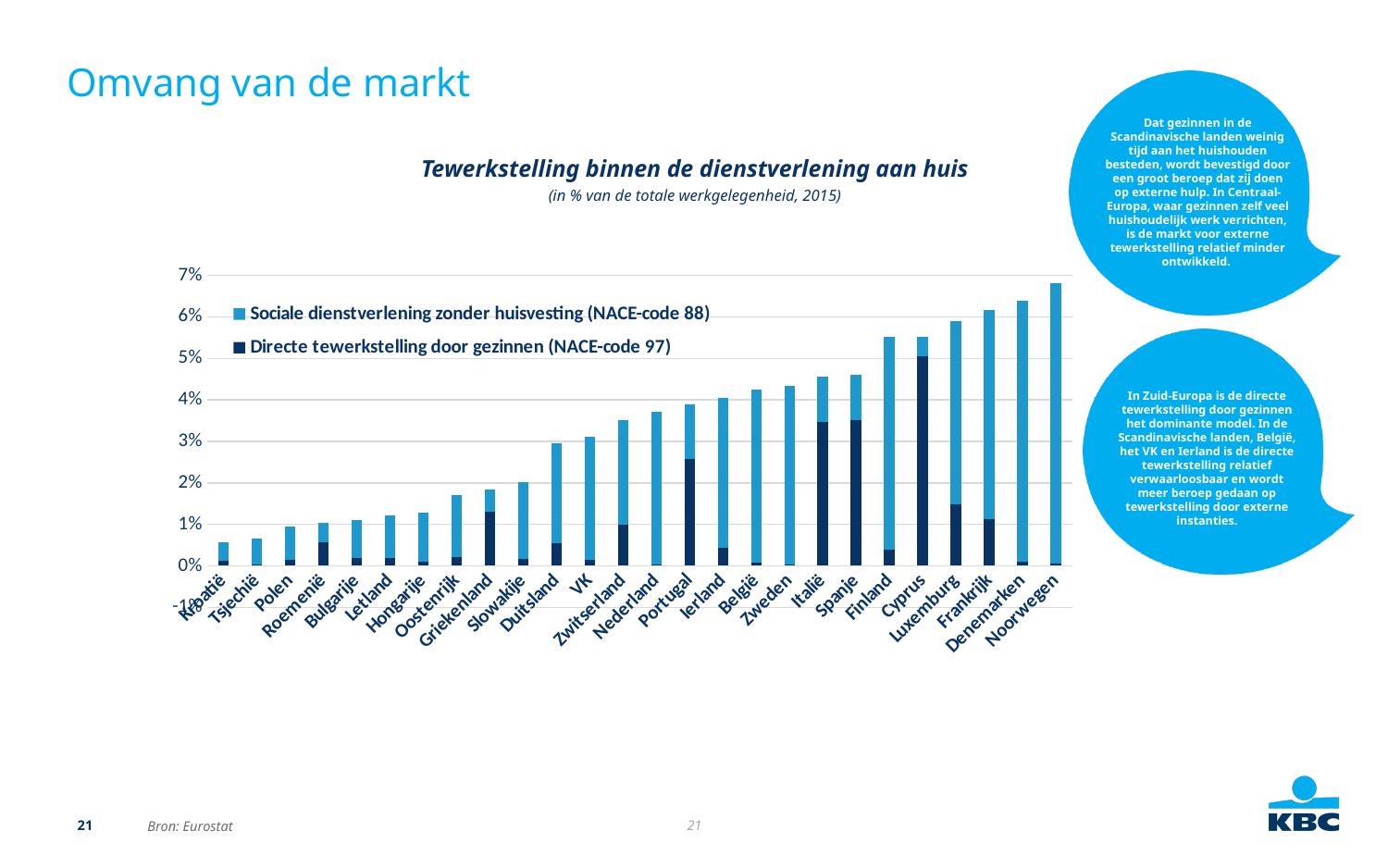
Is the total value for Italië greater or less than 4%? greater Which country has the highest total employment in home services? Noorwegen Is the total value for Kroatië greater or less than 1%? less Which country has the lowest total employment in home services? Kroatië How many countries are shown on the x axis of the chart? 26 Which country has the largest share of 'Directe tewerkstelling door gezinnen (NACE-code 97)'? Cyprus What kind of chart is shown on the slide? Stacked bar chart Which country has a higher total value, Spanje or Polen? Spanje Do the total values rise or fall from left to right along the x axis? rise Is the total value for Noorwegen greater or less than 6%? greater How many series does the legend list? 2